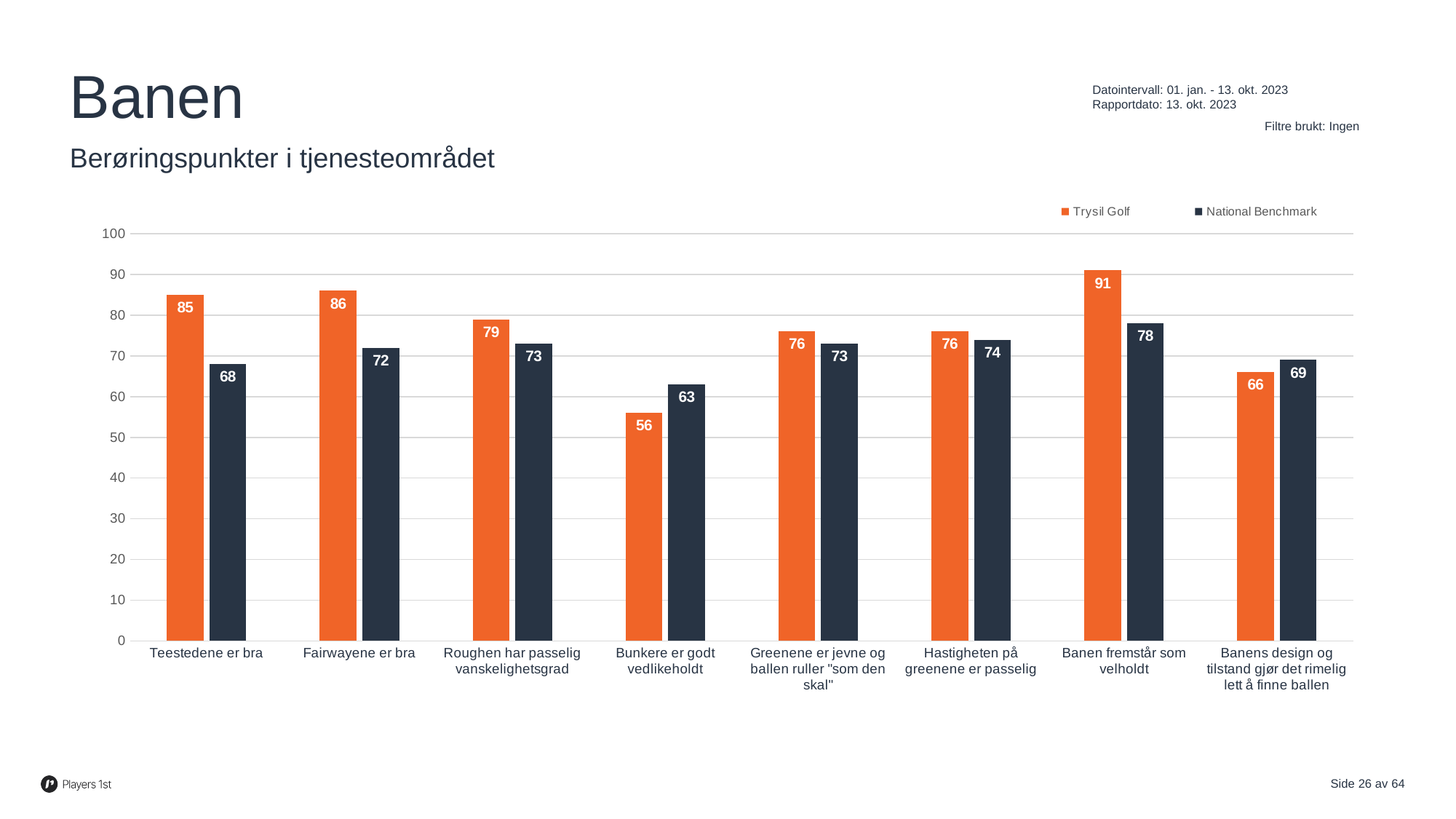
Which category has the highest Trysil Golf value? Banen fremstår som velholdt What is the difference between the Trysil Golf and National Benchmark values for "Teestedene er bra"? 17 How many categories are shown on the x axis? 8 What is the Trysil Golf value for "Teestedene er bra"? 85 Which series is shown in orange in the legend? Trysil Golf Which category has the lowest National Benchmark value? Bunkere er godt vedlikeholdt What is the National Benchmark value for "Bunkere er godt vedlikeholdt"? 63 What is the National Benchmark value for "Banen fremstår som velholdt"? 78 Which category has the lowest Trysil Golf value? Bunkere er godt vedlikeholdt For "Banens design og tilstand gjør det rimelig lett å finne ballen", which is larger: Trysil Golf or National Benchmark? National Benchmark What kind of chart is shown on the slide? Bar chart How many series does the legend list? 2